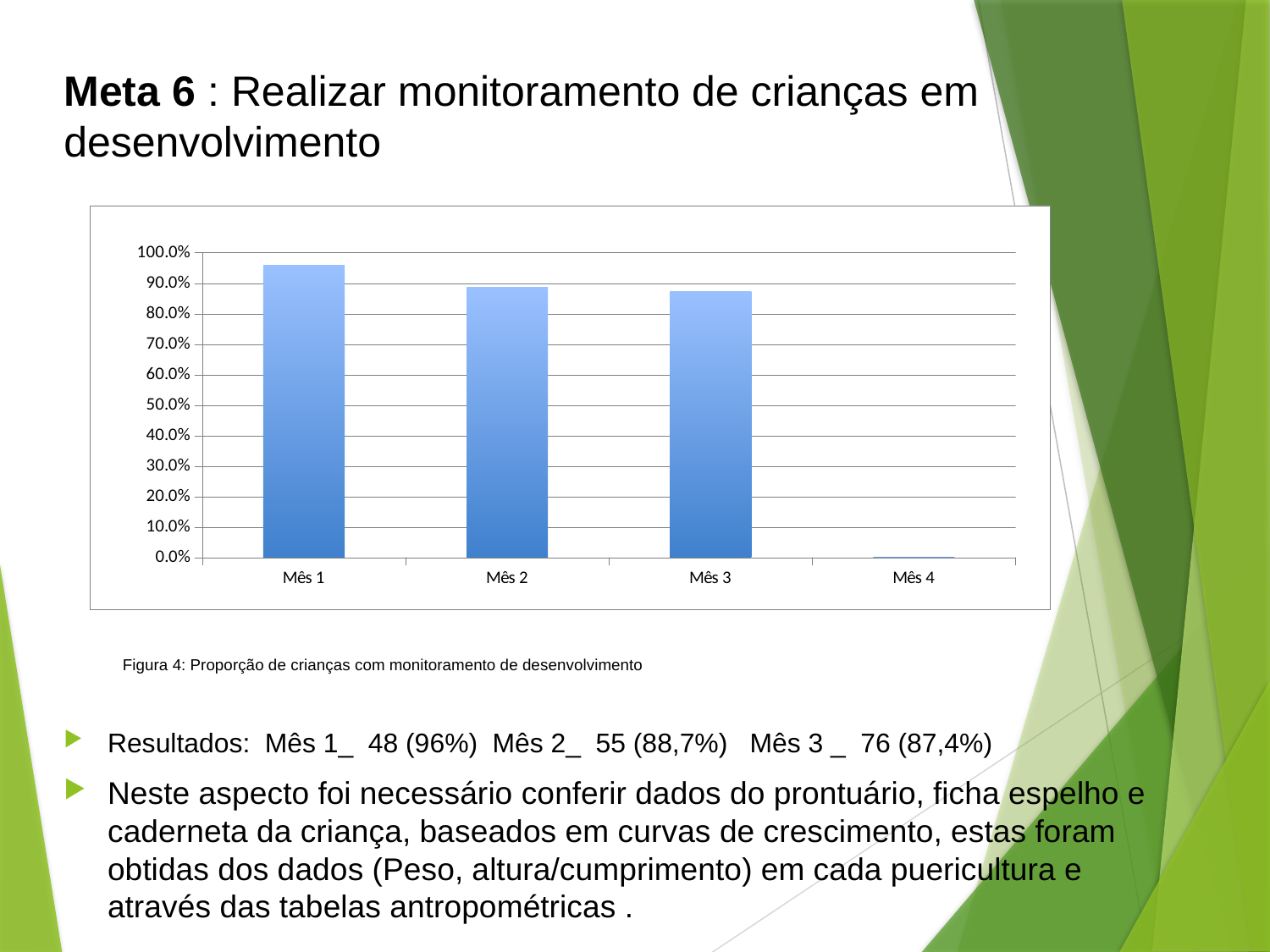
How many categories are shown on the x axis of the chart? 4 Is the value for Mês 3 greater or less than 90.0%? less Which category has the lowest bar in the chart? Mês 4 What kind of chart is shown on the slide? bar chart Which is larger, the value for Mês 1 or the value for Mês 2? Mês 1 Which category has the highest bar in the chart? Mês 1 What is the caption given below the chart? Figura 4: Proporção de crianças com monitoramento de desenvolvimento Is the value for Mês 2 greater or less than 80.0%? greater Is the value for Mês 1 greater or less than 90.0%? greater Do the bar values rise or fall from Mês 1 to Mês 4? fall What is the highest tick value shown on the y axis of the chart? 100.0%